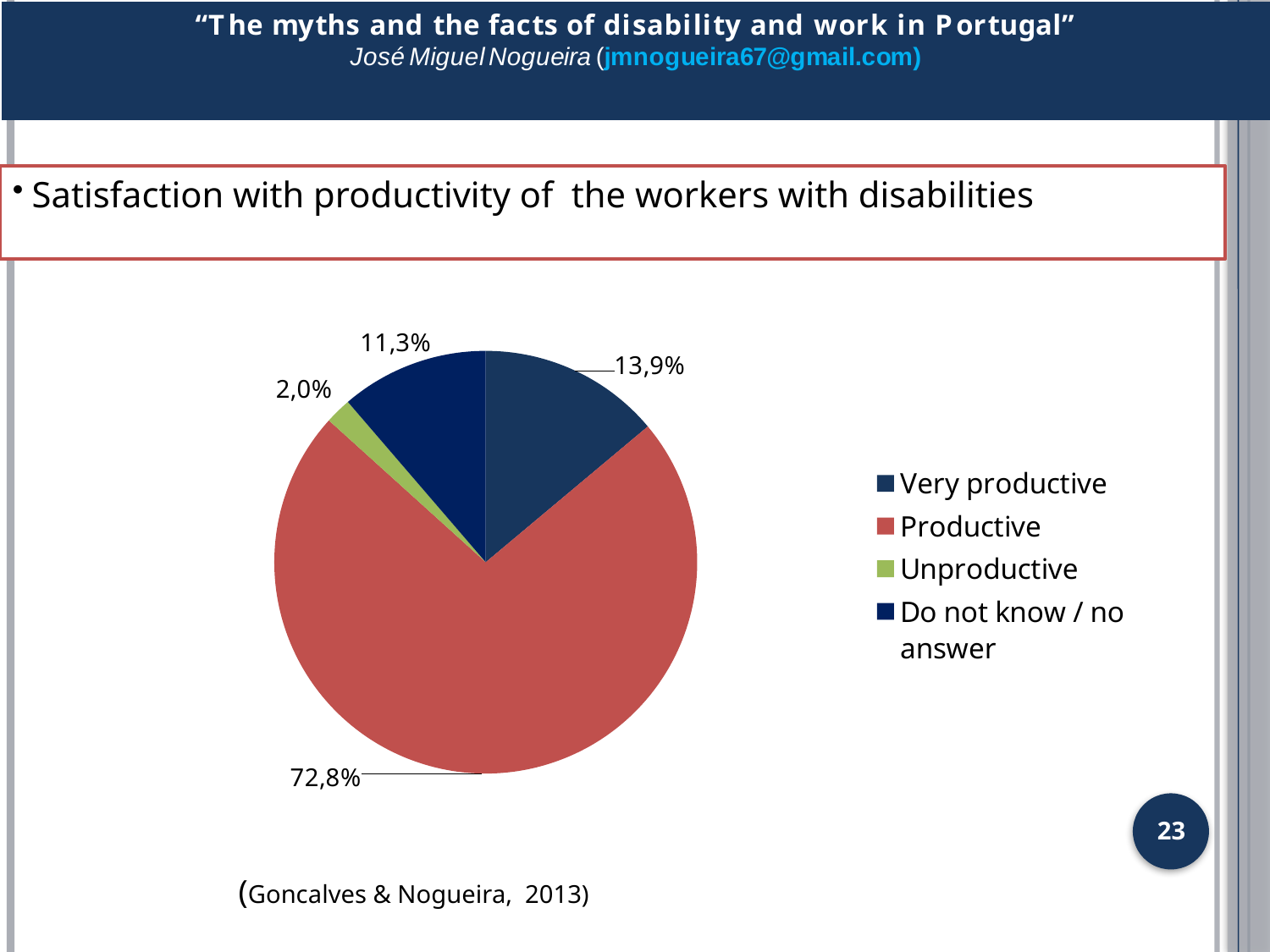
Which is larger, the share for "Very productive" or the share for "Do not know / no answer"? Very productive How many entries does the legend list? 4 What kind of chart is shown on the slide? pie chart What colour is the "Unproductive" slice in the pie chart? green Which category has the smallest slice of the pie? Unproductive What is the difference in percentage points between "Productive" and "Very productive"? 58,9 What share of the pie is labelled "Productive"? 72,8% Which category has the largest slice of the pie? Productive What percentage is shown for "Very productive"? 13,9% What percentage is shown for "Do not know / no answer"? 11,3% How many slices does the pie chart have? 4 What percentage is shown for "Unproductive"? 2,0%